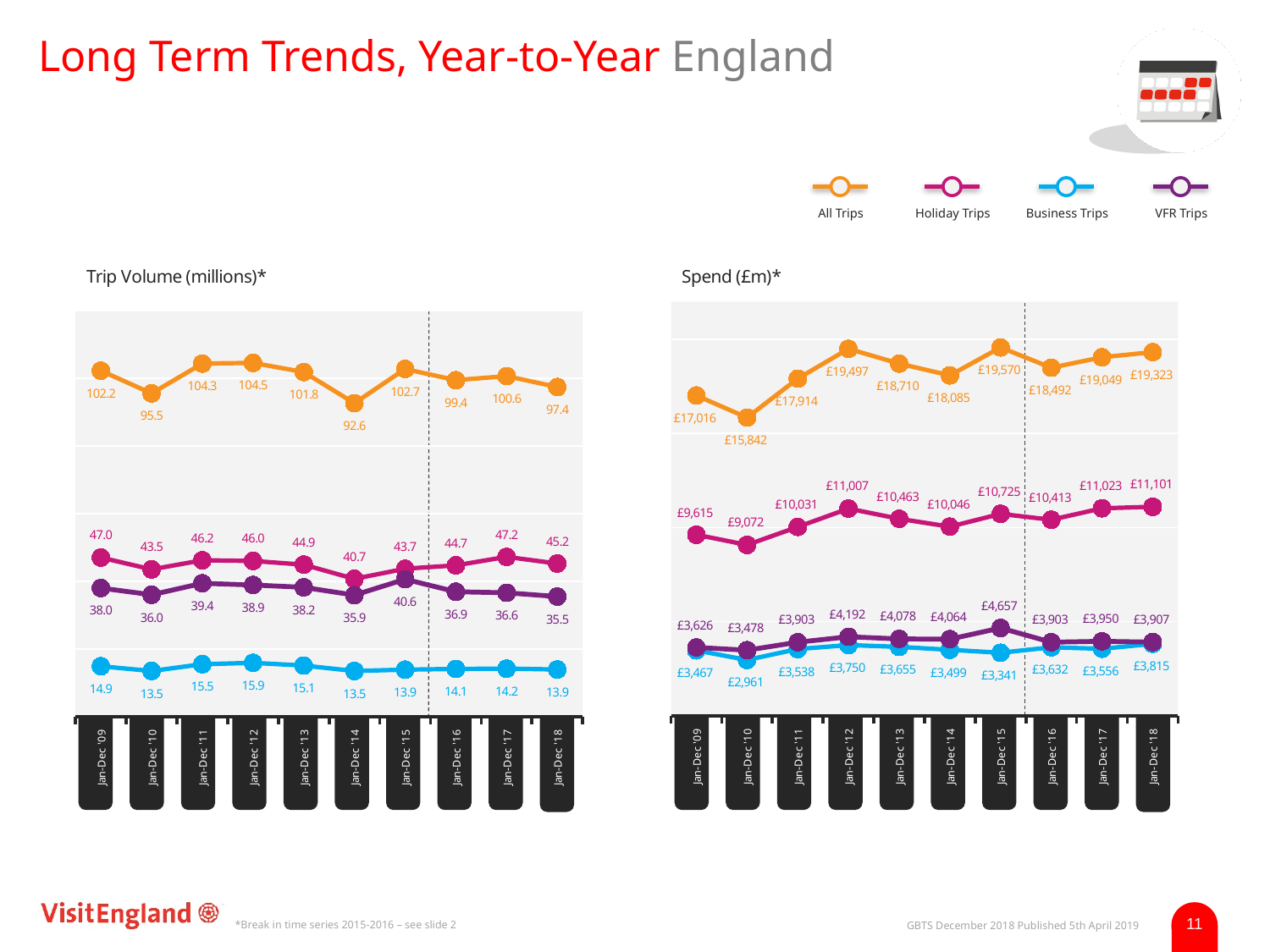
In the Spend (£m) chart, what is the value for Holiday Trips in Jan-Dec '12? £11,007 What kind of chart is the Spend (£m) chart? Line chart In the Trip Volume (millions) chart, what is the difference between the Holiday Trips values for Jan-Dec '17 and Jan-Dec '14? 6.5 In the Spend (£m) chart, which is larger in Jan-Dec '18: VFR Trips or Business Trips? VFR Trips In the Trip Volume (millions) chart, in which year is the All Trips value lowest? Jan-Dec '14 In the Spend (£m) chart, in which year is the VFR Trips value highest? Jan-Dec '15 In the Trip Volume (millions) chart, what is the value for All Trips in Jan-Dec '18? 97.4 In the Trip Volume (millions) chart, what is the value for Business Trips in Jan-Dec '12? 15.9 How many series does the legend list for the charts on this slide? 4 How many years are shown on the x axis of the Trip Volume (millions) chart? 10 In the Trip Volume (millions) chart, which is larger in Jan-Dec '15: Holiday Trips or VFR Trips? Holiday Trips In the Spend (£m) chart, what is the difference between the All Trips values for Jan-Dec '15 and Jan-Dec '10? £3,728